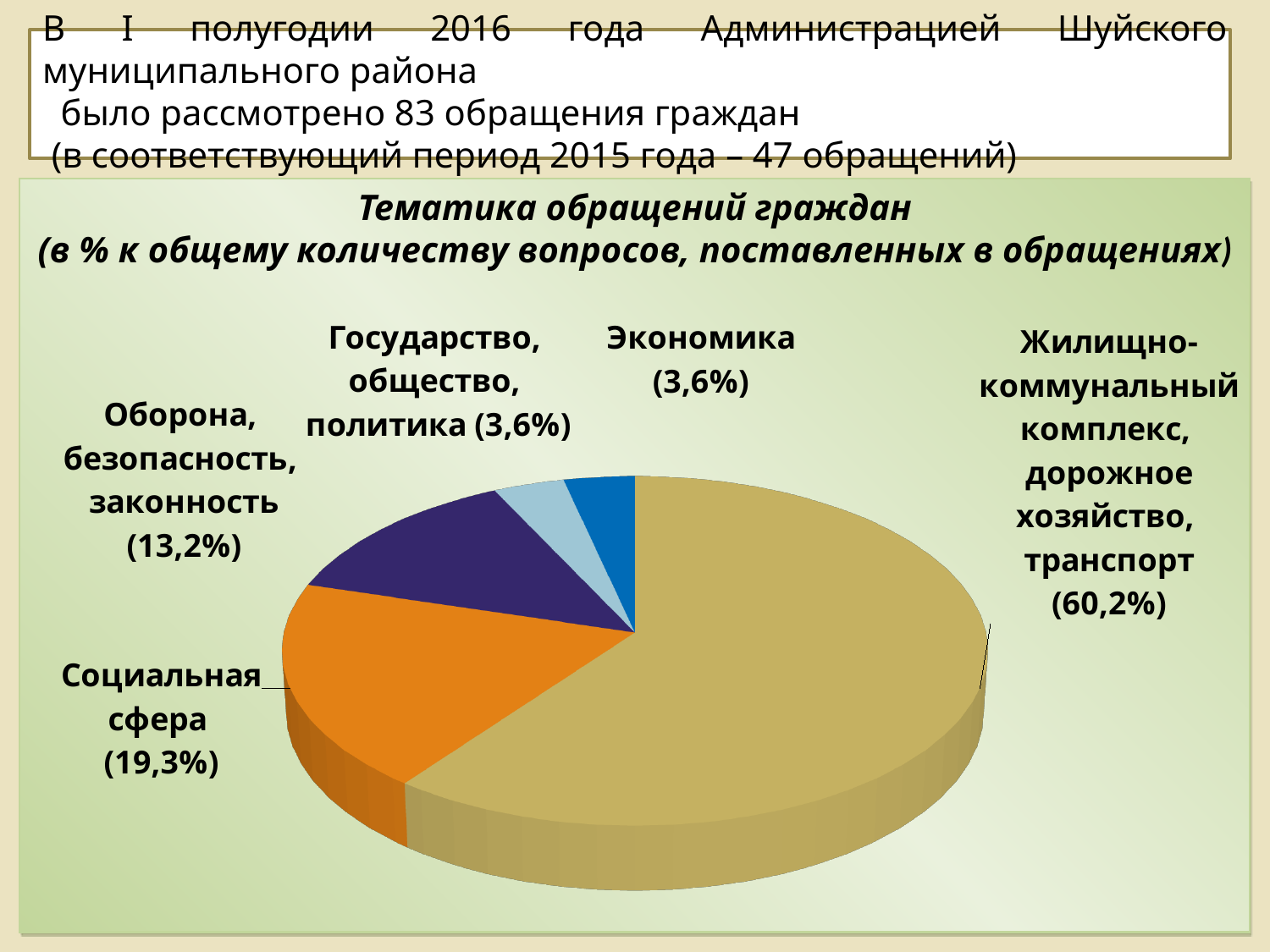
What is the first line of the chart's title? Тематика обращений граждан Which category has the largest share of the pie? Жилищно-коммунальный комплекс, дорожное хозяйство, транспорт What value is shown for Оборона, безопасность, законность? 13,2% What percentage of citizens' appeals concerned Жилищно-коммунальный комплекс, дорожное хозяйство, транспорт? 60,2% What type of chart is shown on the slide? Pie chart What percentage is shown for Экономика? 3,6% What share of the pie is labelled Социальная сфера? 19,3% What is the difference in percentage points between Социальная сфера and Оборона, безопасность, законность? 6,1 Which is larger: the share for Социальная сфера or for Оборона, безопасность, законность? Социальная сфера What value is given for Государство, общество, политика? 3,6% How many categories (slices) does the pie chart show? 5 By how many percentage points does the share for Жилищно-коммунальный комплекс exceed the share for Социальная сфера? 40,9